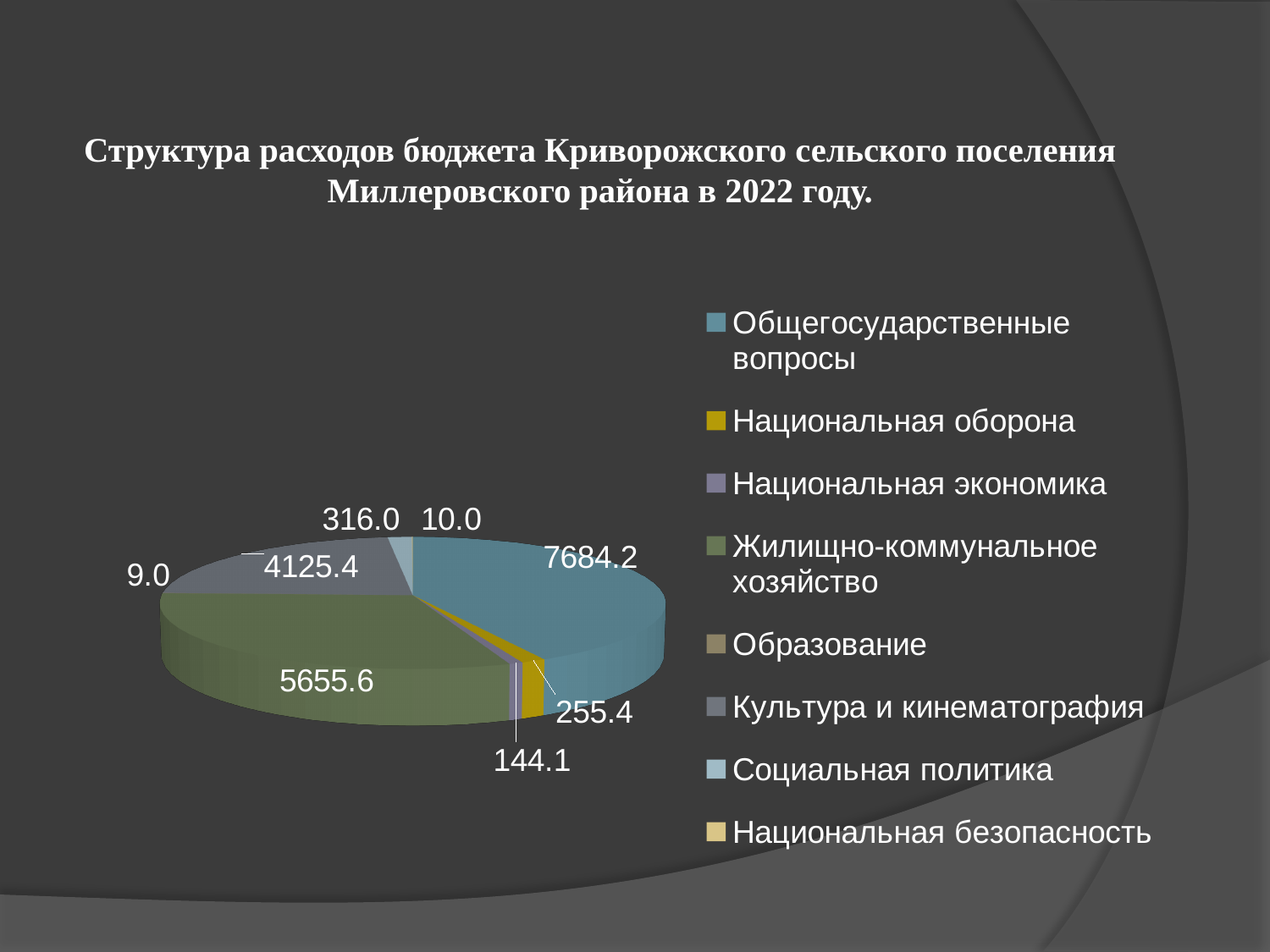
Which is larger: the value for Жилищно-коммунальное хозяйство or the value for Культура и кинематография? Жилищно-коммунальное хозяйство What is the value shown for Жилищно-коммунальное хозяйство? 5655.6 Which category has the largest slice of the pie? Общегосударственные вопросы What is the smallest value printed on the pie chart? 9.0 How many data labels are printed on the pie chart? 8 What is the value shown for Культура и кинематография? 4125.4 What is the value shown for Общегосударственные вопросы? 7684.2 How many categories does the legend of the pie chart list? 8 What is the value shown for Национальная оборона? 255.4 What year does the chart title say the budget expenditure structure refers to? 2022 What is the difference between the values for Общегосударственные вопросы and Жилищно-коммунальное хозяйство? 2028.6 What type of chart is shown on the slide? Pie chart